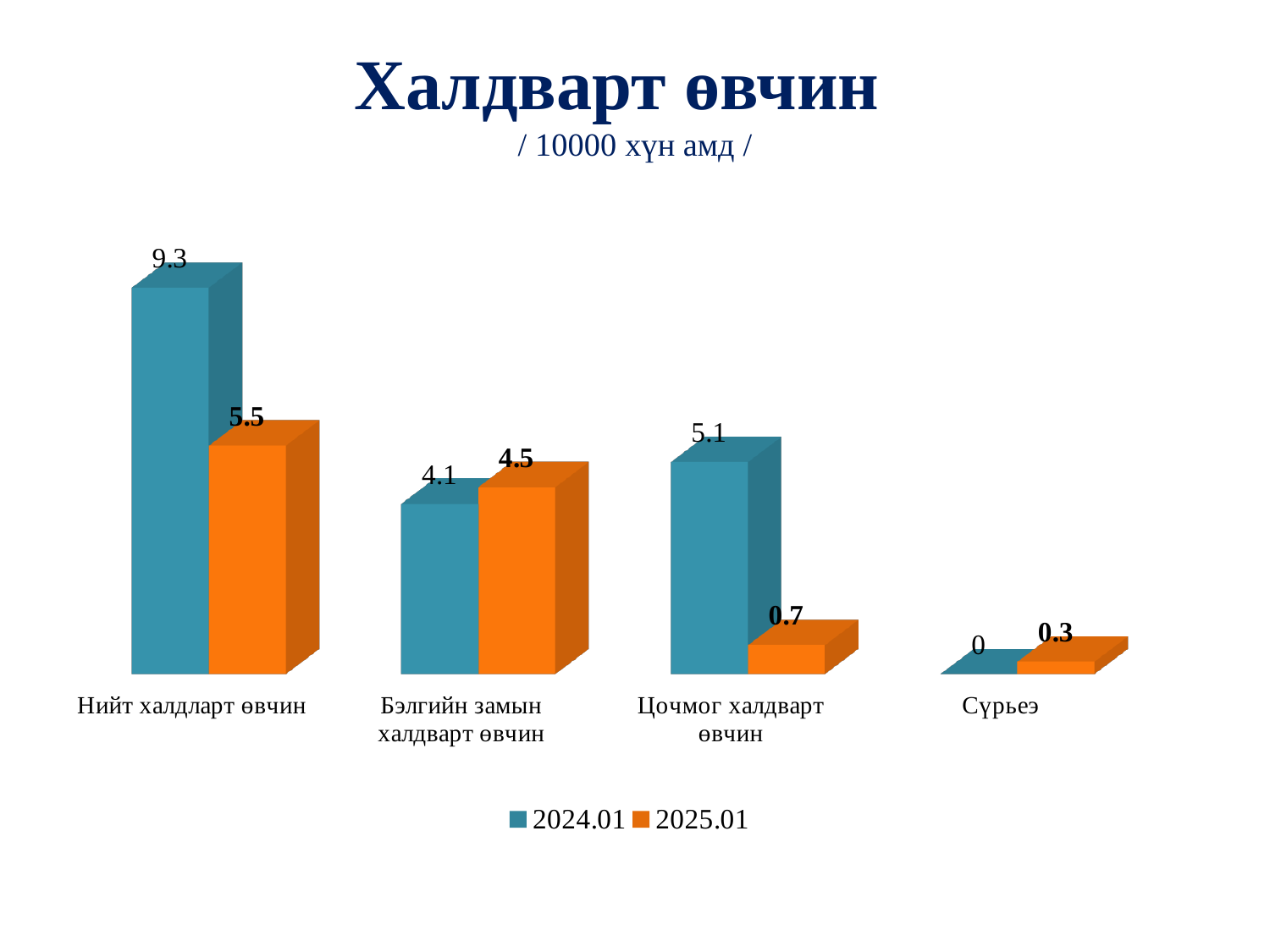
What is the value for Нийт халдларт өвчин in the 2025.01 series? 5.5 What is the value for Бэлгийн замын халдварт өвчин in the 2025.01 series? 4.5 What is the value for Нийт халдларт өвчин in the 2024.01 series? 9.3 What is the value for Цочмог халдварт өвчин in the 2024.01 series? 5.1 For Бэлгийн замын халдварт өвчин, which series has the larger value, 2024.01 or 2025.01? 2025.01 What kind of chart is shown on the slide? Bar chart How many categories are shown on the x axis? 4 What is the difference between the 2024.01 and 2025.01 values for Цочмог халдварт өвчин? 4.4 How many series does the legend list? 2 What is the value for Сүрьеэ in the 2025.01 series? 0.3 Which category has the highest value in the 2024.01 series? Нийт халдларт өвчин Which category has the lowest value in the 2025.01 series? Сүрьеэ